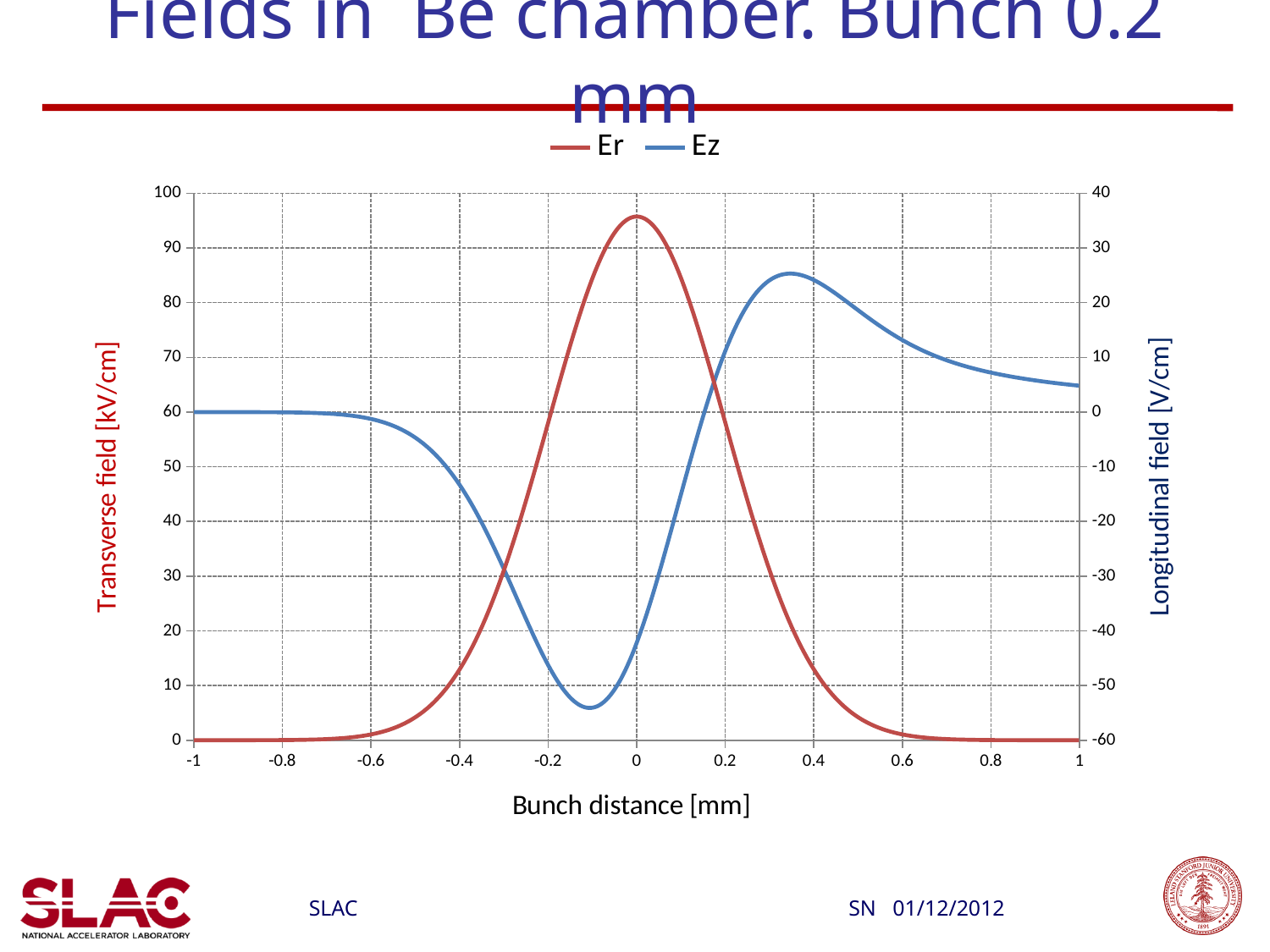
Is the value of Er at a bunch distance of 0.2 mm greater or less than 50 kV/cm? greater Is the maximum value of Ez greater or less than 20 V/cm? greater Does the Ez curve rise or fall as the bunch distance goes from 0.4 mm to 1 mm? fall What kind of chart is shown on the slide? line chart Does the Er curve rise or fall as the bunch distance goes from 0 mm to 1 mm? fall How many series does the legend list? 2 Is the value of Ez at a bunch distance of 1 mm greater or less than 0 V/cm? greater What are the two series named in the legend? Er and Ez What is the title of the x axis? Bunch distance [mm]